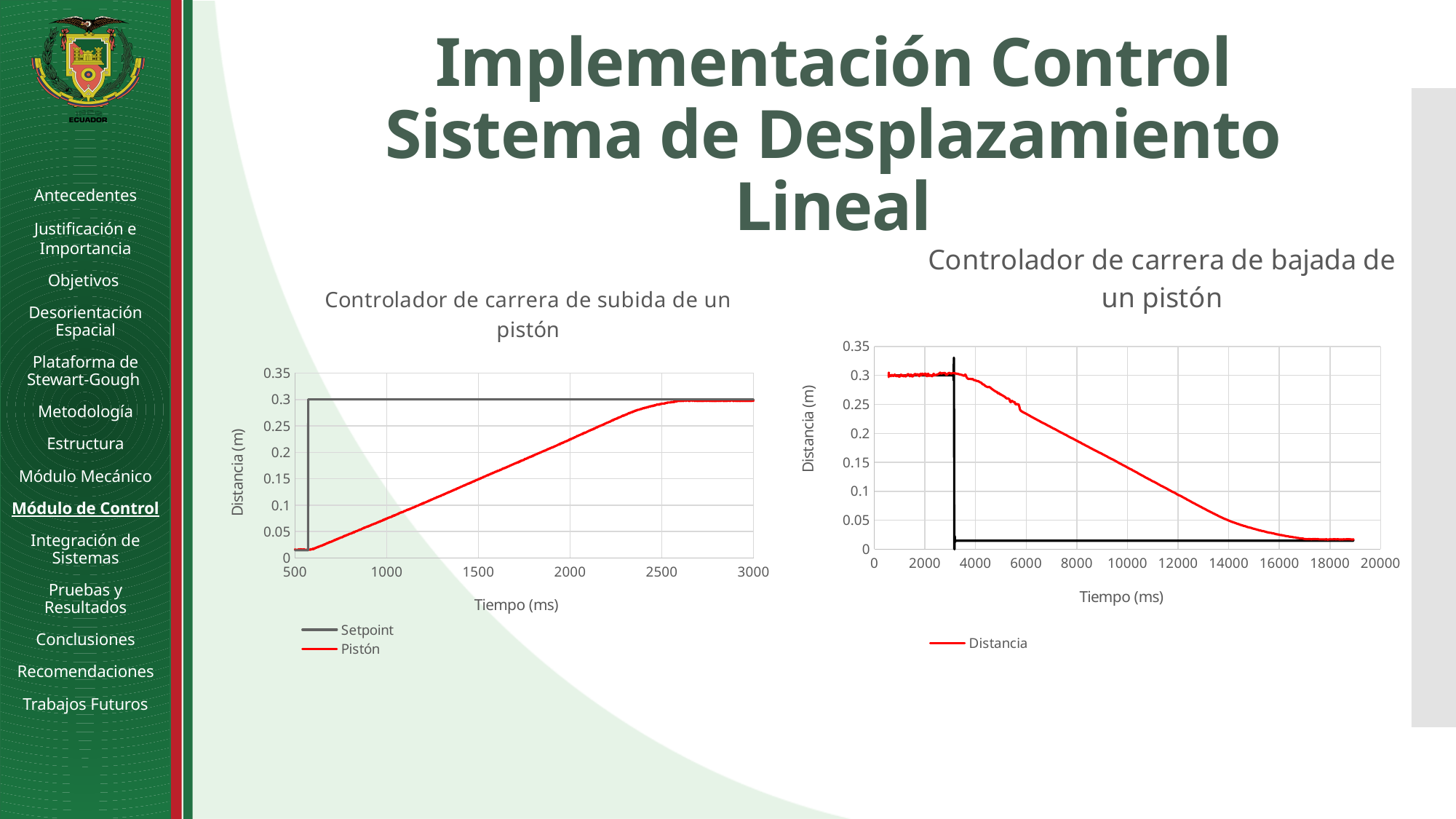
In the 'Controlador de carrera de bajada de un pistón' chart, does the Distancia line rise or fall between 4000 ms and 16000 ms? fall In the 'Controlador de carrera de subida de un pistón' chart, what colour is the Pistón line? red What kind of chart is the 'Controlador de carrera de bajada de un pistón' chart? line chart In the 'Controlador de carrera de subida de un pistón' chart, does the Pistón line rise or fall between 1000 ms and 2500 ms? rise In the 'Controlador de carrera de bajada de un pistón' chart, is the Distancia value at 2000 ms greater or less than 0.25? greater In the 'Controlador de carrera de bajada de un pistón' chart, is the Distancia value at 14000 ms greater or less than 0.1? less In the 'Controlador de carrera de subida de un pistón' chart, is the Pistón value at 1500 ms greater or less than 0.2? less How many series does the legend of the 'Controlador de carrera de subida de un pistón' chart list? 2 What is the x-axis title of the 'Controlador de carrera de subida de un pistón' chart? Tiempo (ms) What kind of chart is the 'Controlador de carrera de subida de un pistón' chart? line chart How many series does the legend of the 'Controlador de carrera de bajada de un pistón' chart list? 1